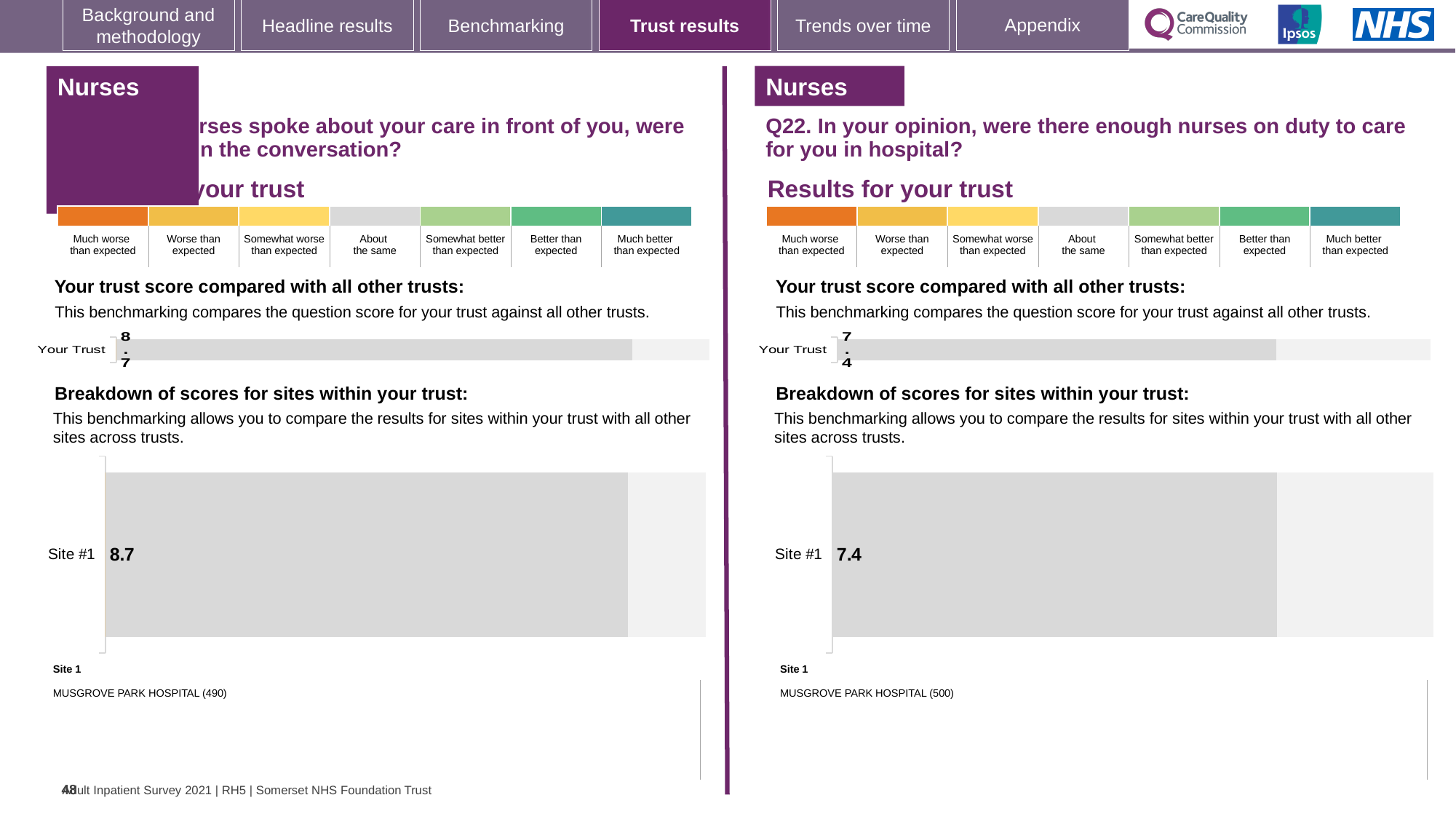
On the right-hand Q22 panel, is the Site #1 score the same as the Your Trust score? Yes, both are 7.4 How many sites are shown in the site breakdown chart on the right-hand Q22 panel? 1 On the right-hand Q22 site breakdown chart, which hospital is listed as Site 1? MUSGROVE PARK HOSPITAL (500) On the right-hand Q22 site breakdown chart, what is the score for Site #1? 7.4 On the right-hand chart for Q22 (enough nurses on duty), what is the score shown for Your Trust? 7.4 On the left-hand chart (nurses speaking about your care in front of you), what is the score shown for Your Trust? 8.7 How many sites are shown in the site breakdown chart on the left-hand panel? 1 On the left-hand site breakdown chart, what is the score for Site #1? 8.7 On the left-hand site breakdown chart, which hospital is listed as Site 1? MUSGROVE PARK HOSPITAL (490) What type of chart is used to show the Your Trust score on the right-hand Q22 panel? Bar chart Which is larger: the Your Trust score on the left-hand chart or the Your Trust score on the right-hand Q22 chart? Left-hand chart (8.7) What is the difference between the Site #1 score on the left-hand chart (8.7) and the Site #1 score on the right-hand Q22 chart (7.4)? 1.3